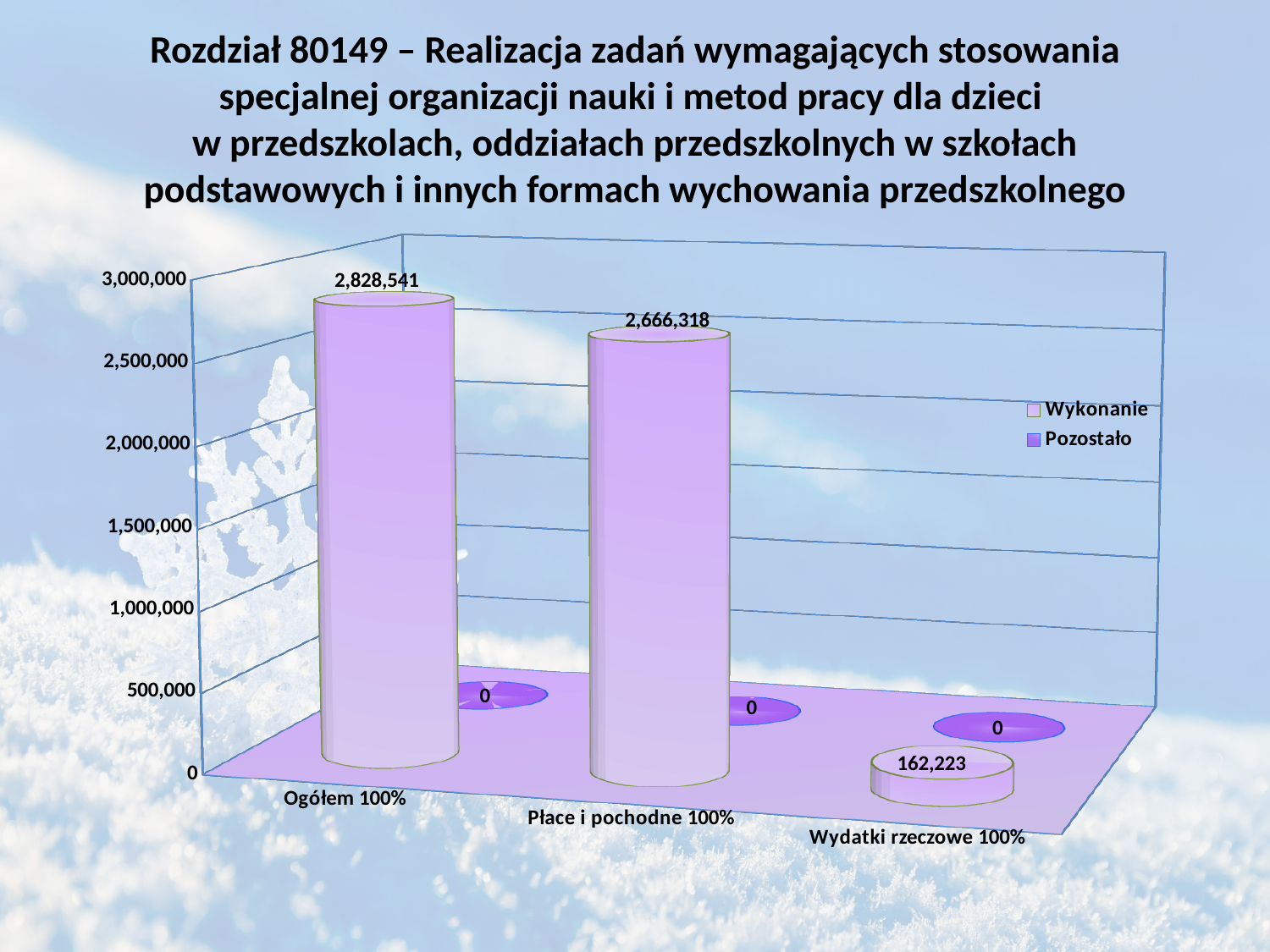
Which is larger, the Wykonanie value for Płace i pochodne 100% or for Wydatki rzeczowe 100%? Płace i pochodne 100% Which category has the lowest Wykonanie value? Wydatki rzeczowe 100% What is the Wykonanie value for Wydatki rzeczowe 100%? 162,223 Which category has the highest Wykonanie value? Ogółem 100% What kind of chart is shown on the slide? bar chart What is the Pozostało value for Ogółem 100%? 0 How many series does the legend list? 2 What is the Wykonanie value for Płace i pochodne 100%? 2,666,318 How many categories are shown on the x axis? 3 Is the Wykonanie value for Płace i pochodne 100% greater or less than 2,500,000? greater What is the Wykonanie value for Ogółem 100%? 2,828,541 What is the difference between the Wykonanie values for Ogółem 100% and Płace i pochodne 100%? 162,223